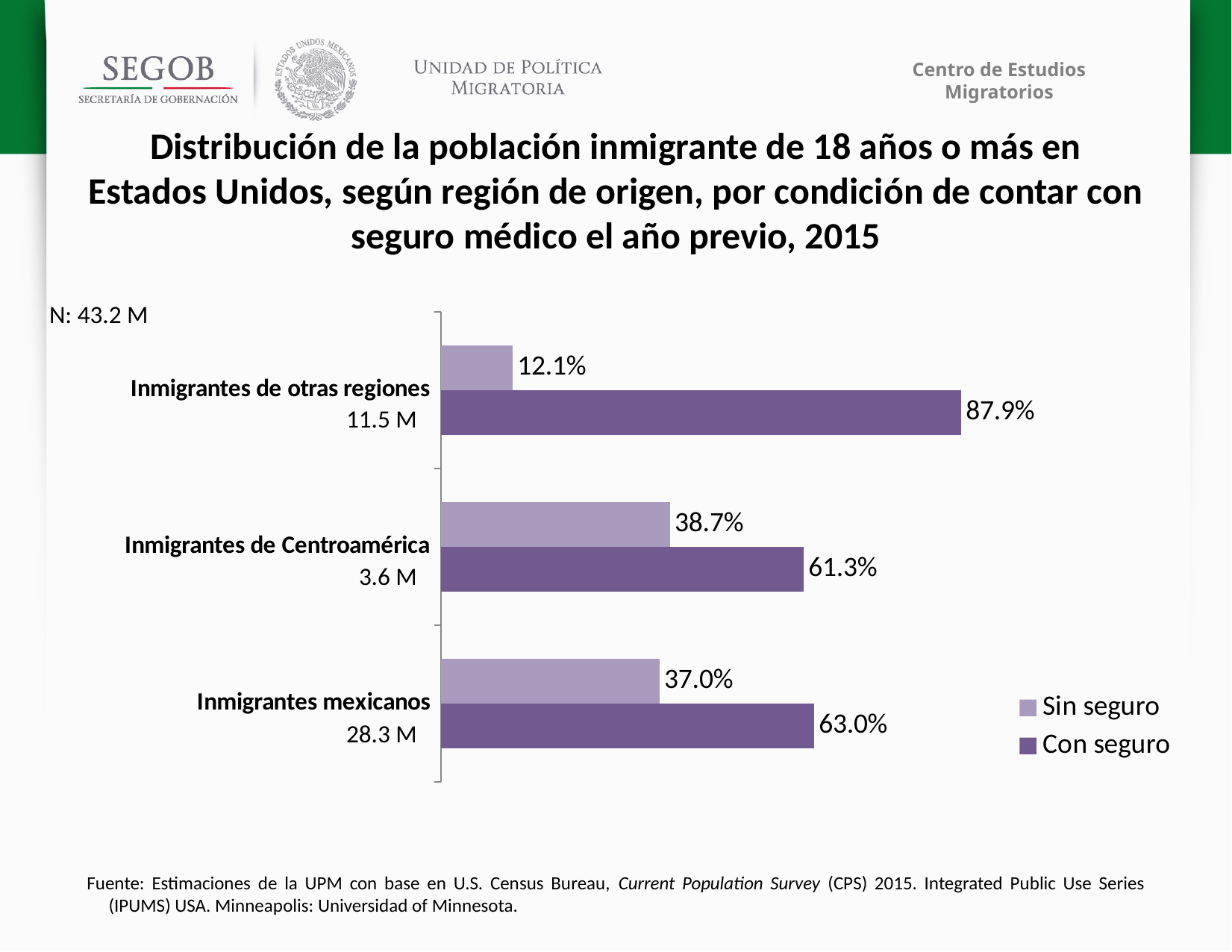
How many series does the legend list? 2 What is the difference between the 'Con seguro' and 'Sin seguro' values for Inmigrantes de Centroamérica? 22.6% What is the 'Con seguro' value for Inmigrantes mexicanos? 63.0% Which category has the lowest 'Sin seguro' value? Inmigrantes de otras regiones Which category has the highest 'Con seguro' value? Inmigrantes de otras regiones How many categories (regions of origin) are shown in the chart? 3 What is the 'Sin seguro' value for Inmigrantes de Centroamérica? 38.7% What is the 'Sin seguro' value for Inmigrantes de otras regiones? 12.1% Which is larger: the 'Sin seguro' value for Inmigrantes de Centroamérica or for Inmigrantes mexicanos? Inmigrantes de Centroamérica What kind of chart is shown on the slide? Bar chart What is the total population (N) shown for the chart? 43.2 M What population size is shown for Inmigrantes mexicanos? 28.3 M